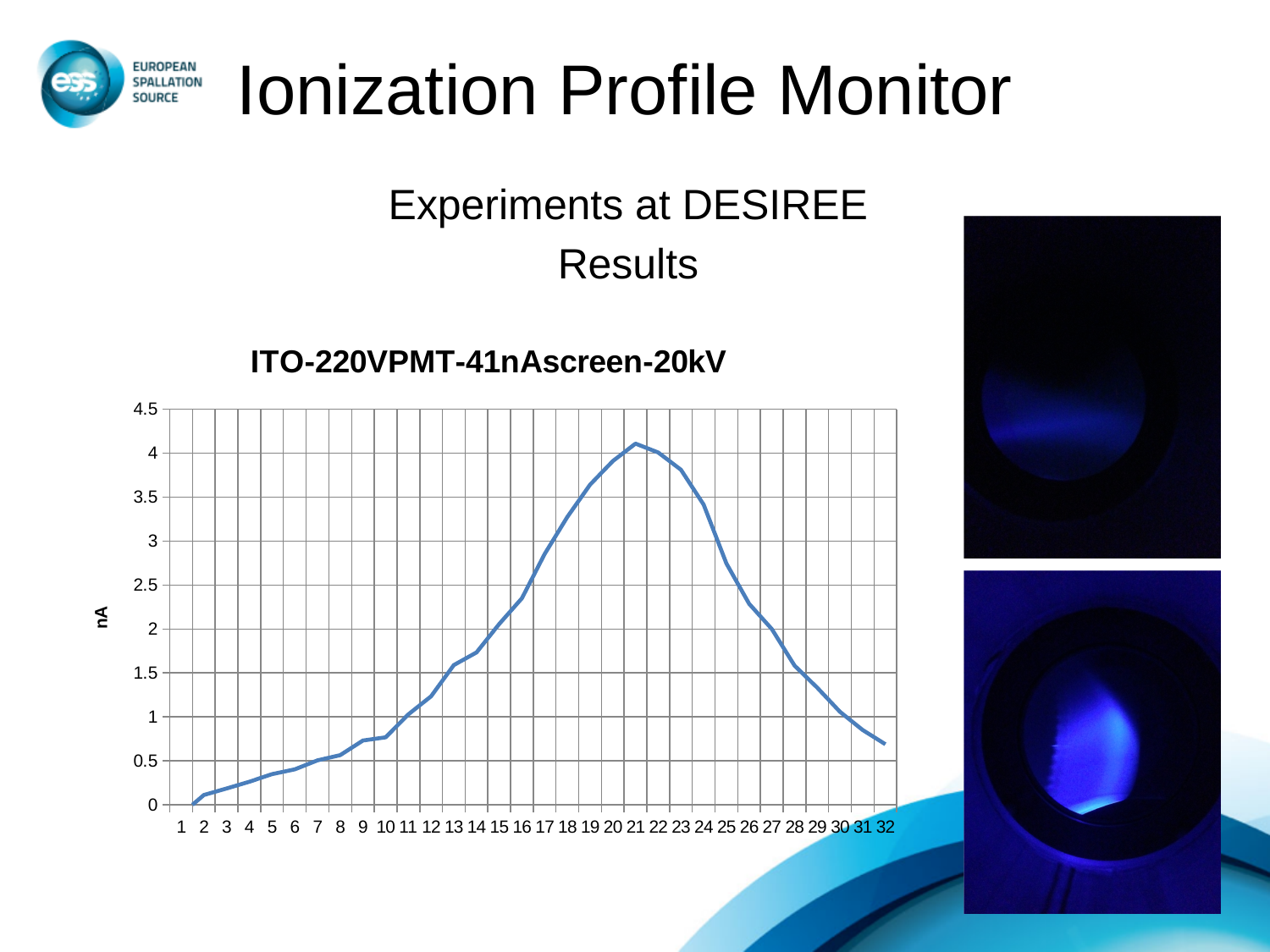
Is the value at point 16 greater or less than 2? greater Is the value at point 21 greater or less than 4? greater Is the value at point 5 greater or less than 0.5? less What is the label on the y axis of the chart? nA How many points are plotted along the x axis of the chart? 32 How does the line behave from point 1 to point 21 along the x axis? it rises At which x-axis point does the line reach its highest value? 21 What is the title of the chart? ITO-220VPMT-41nAscreen-20kV At which x-axis point does the line have its lowest value? 1 What kind of chart is shown on the slide? line chart